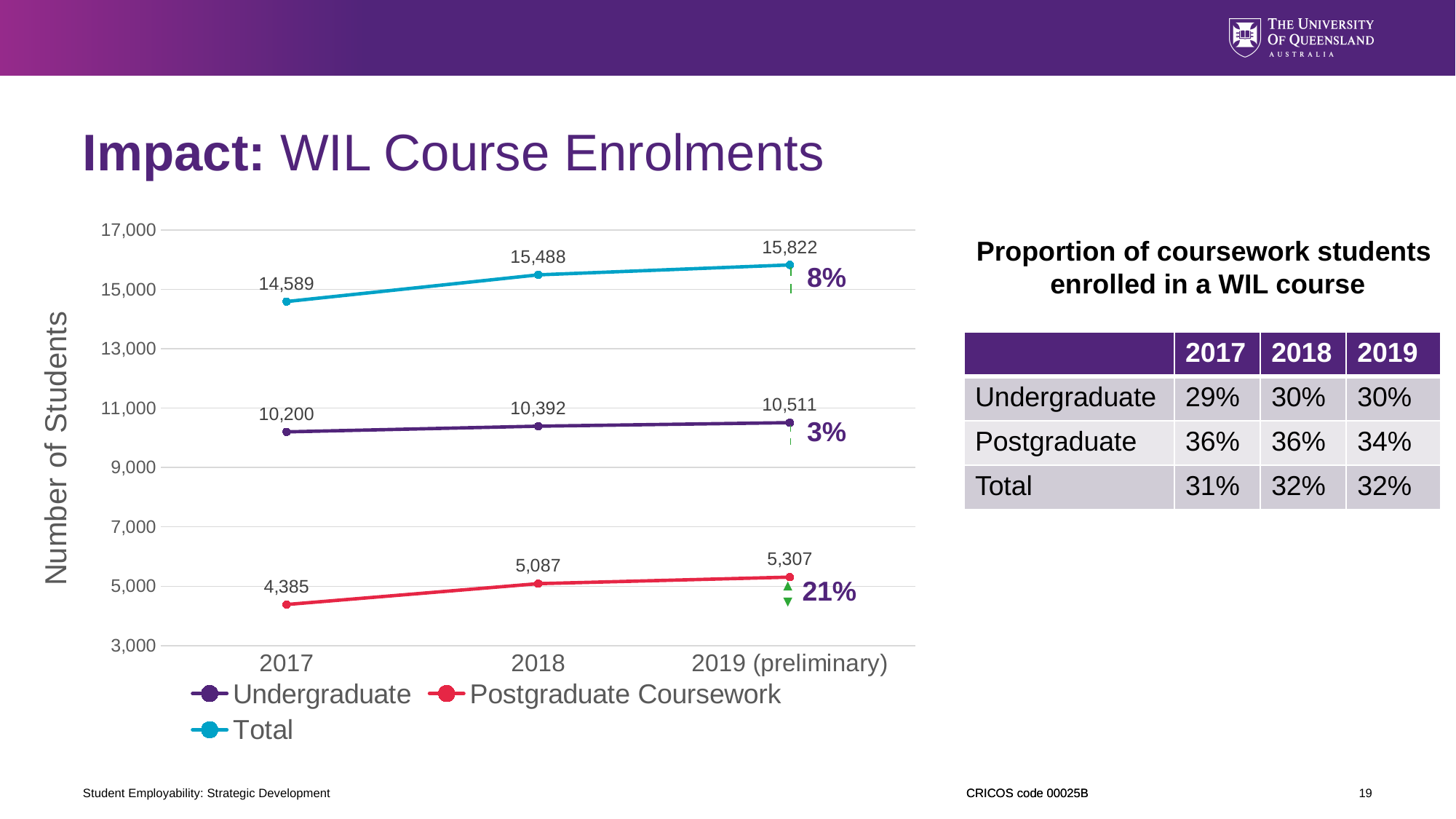
What is the label on the y axis of the chart? Number of Students Does the Undergraduate series rise or fall from 2017 to 2019 (preliminary)? Rise In which year is the Total value highest? 2019 (preliminary) What is the Total number of students in 2017? 14,589 What is the Postgraduate Coursework value for 2018? 5,087 In which year is the Postgraduate Coursework value lowest? 2017 How many years are plotted on the x axis? 3 What is the difference between the Total values for 2019 (preliminary) and 2017? 1,233 What type of chart is shown on the slide? Line chart What is the Undergraduate value for 2019 (preliminary)? 10,511 What is the difference between the Undergraduate and Postgraduate Coursework values in 2019 (preliminary)? 5,204 How many series does the legend list? 3